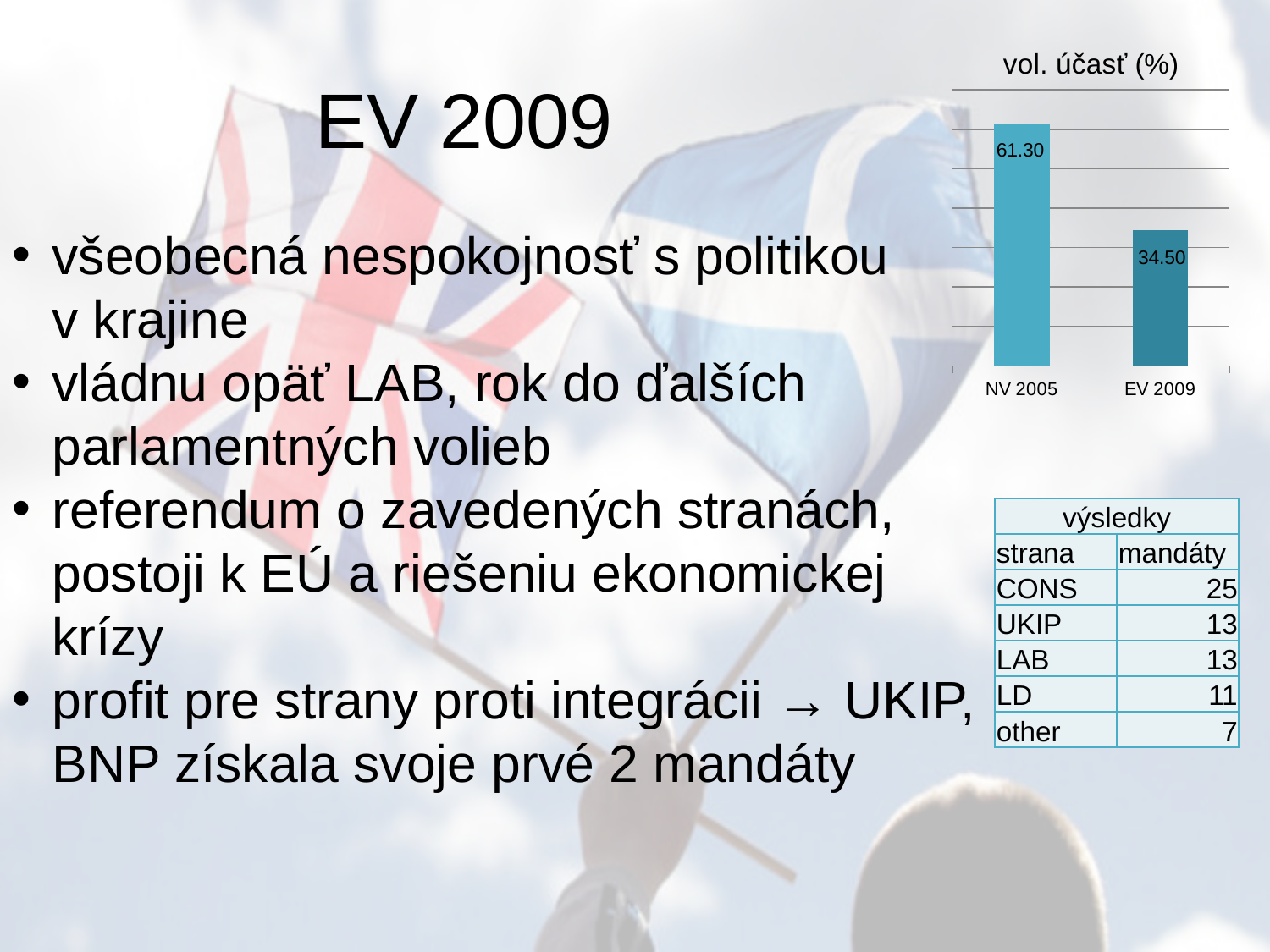
What is the difference between the values for NV 2005 and EV 2009? 26.80 How many categories are shown in the chart? 2 Do the values rise or fall from NV 2005 to EV 2009? fall Which category has the highest value in the chart? NV 2005 What kind of chart is shown on the slide? bar chart What is the value for EV 2009 in the chart? 34.50 What is the value for NV 2005 in the chart? 61.30 Which category has the lowest value in the chart? EV 2009 Which is larger, the value for NV 2005 or the value for EV 2009? NV 2005 What is the title of the chart? vol. účasť (%)